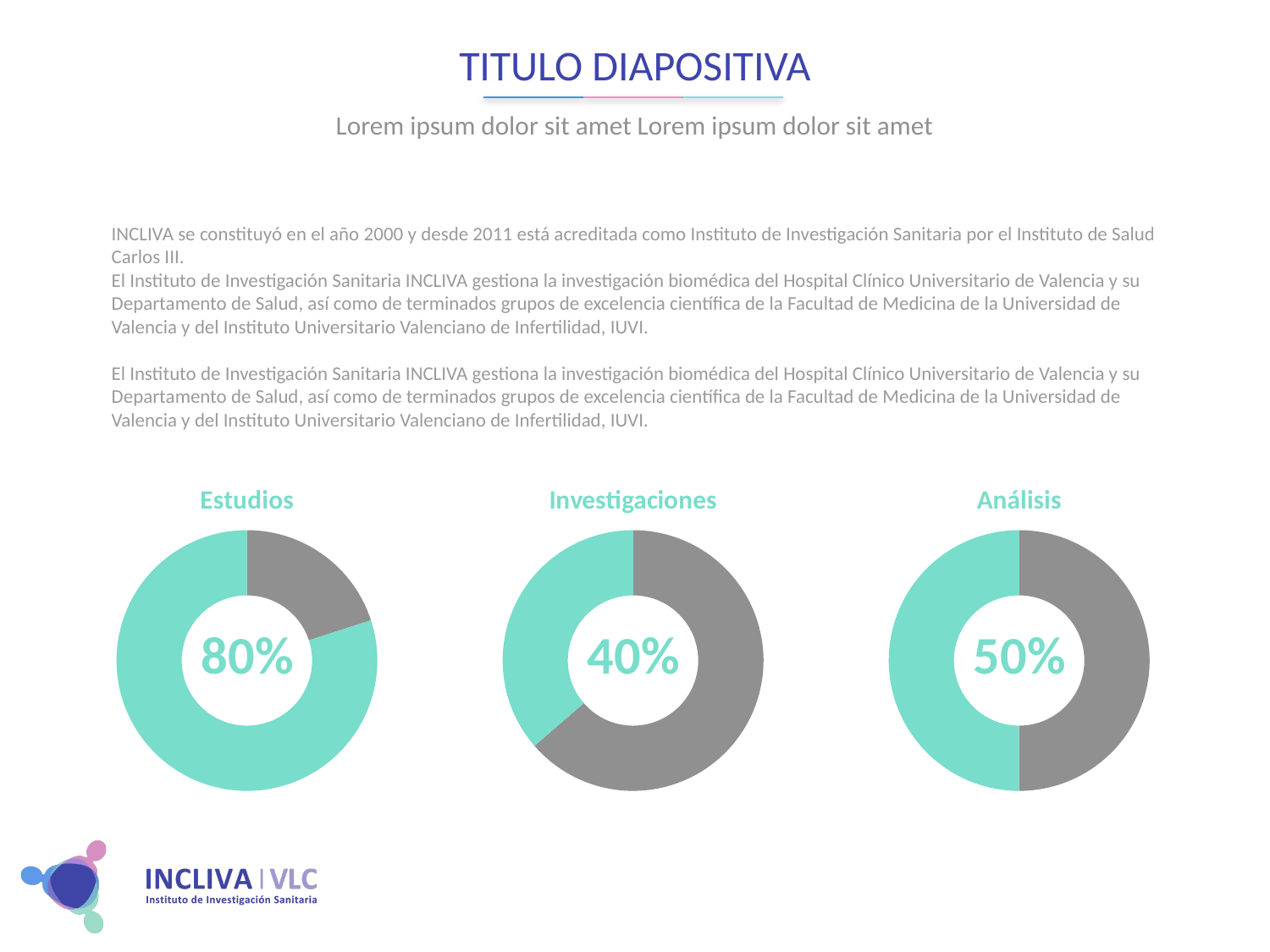
What percentage is shown in the centre of the Estudios chart? 80% What kind of chart is used for Estudios, Investigaciones and Análisis? Doughnut chart What percentage is shown in the centre of the Análisis chart? 50% Which of the three charts shows the highest percentage? Estudios Which of the three charts shows the lowest percentage? Investigaciones What percentage is shown in the centre of the Investigaciones chart? 40% Which is larger, the percentage in the Análisis chart or the percentage in the Investigaciones chart? Análisis How many doughnut charts are on the slide? 3 What is the difference between the percentage in the Estudios chart and the percentage in the Investigaciones chart? 40% What is the title of the middle chart? Investigaciones What is the difference between the percentage in the Análisis chart and the percentage in the Investigaciones chart? 10% In the Análisis chart, what share of the ring is coloured teal? 50%